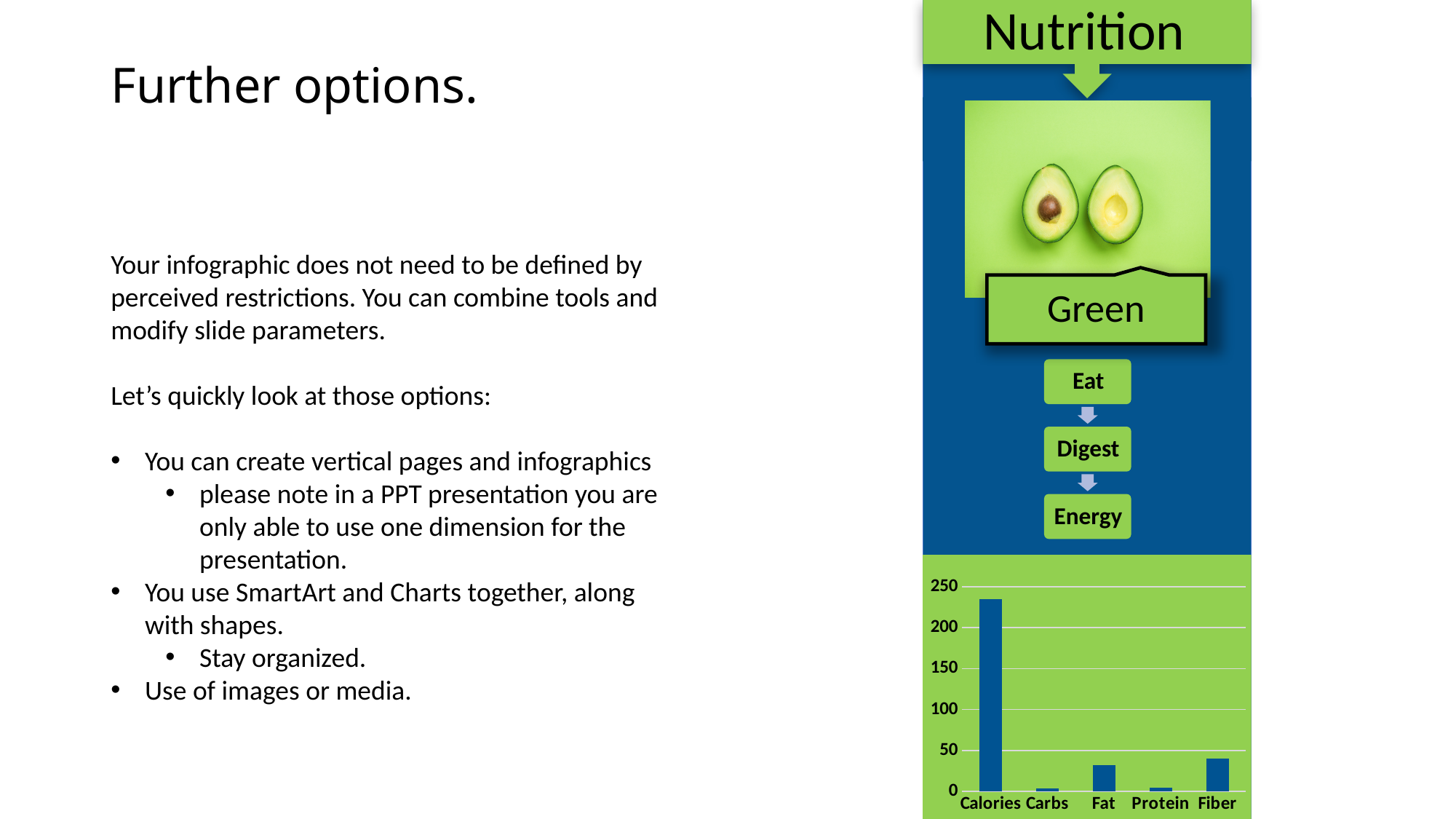
Is the value for Fat greater or less than 50? less Which is larger, the value for Calories or the value for Fiber? Calories What kind of chart is shown at the bottom of the Nutrition infographic? bar chart What is the label of the last category on the x axis of the chart? Fiber Is the value for Carbs greater or less than 50? less What is the highest value shown on the vertical axis of the chart? 250 Is the value for Fiber greater or less than 50? less How many categories are shown on the x axis of the bar chart? 5 Which is larger, the value for Fiber or the value for Fat? Fiber Which category has the highest bar in the chart? Calories